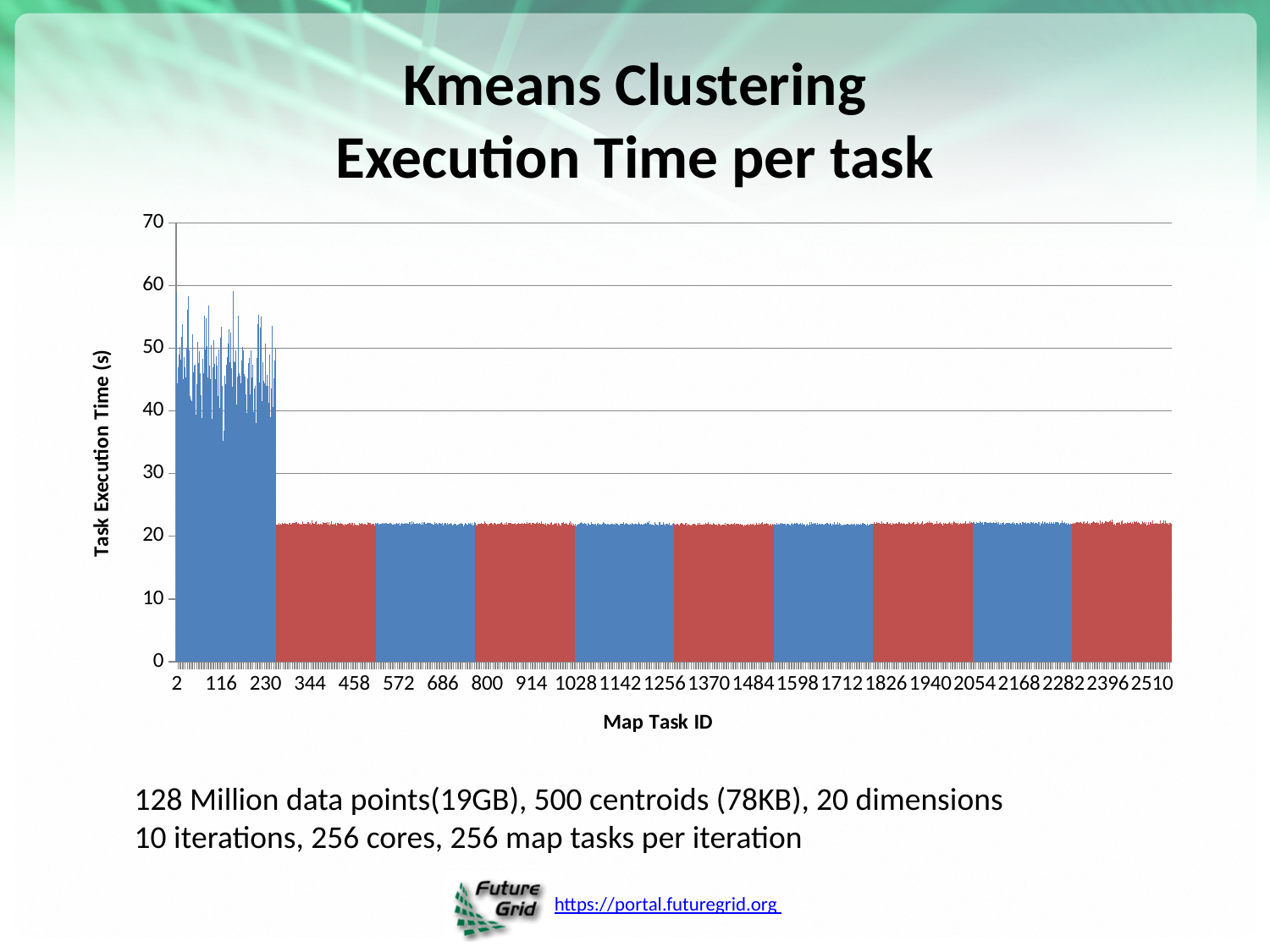
What is the title of the chart? Kmeans Clustering Execution Time per task Which has the larger task execution time: Map Task ID 116 or Map Task ID 1598? Map Task ID 116 What is the label of the vertical axis? Task Execution Time (s) Do the task execution times rise or fall from the first block of map tasks to the later blocks along the x axis? fall Is the task execution time for Map Task ID 1142 greater or less than 30? less Is the task execution time for Map Task ID 116 greater or less than 30? greater How many alternating coloured blocks of bars are shown along the x axis? 10 What is the highest tick value shown on the vertical axis? 70 What kind of chart is shown on the slide? bar chart Is the task execution time for Map Task ID 2510 greater or less than 40? less What is the first Map Task ID label shown on the horizontal axis? 2